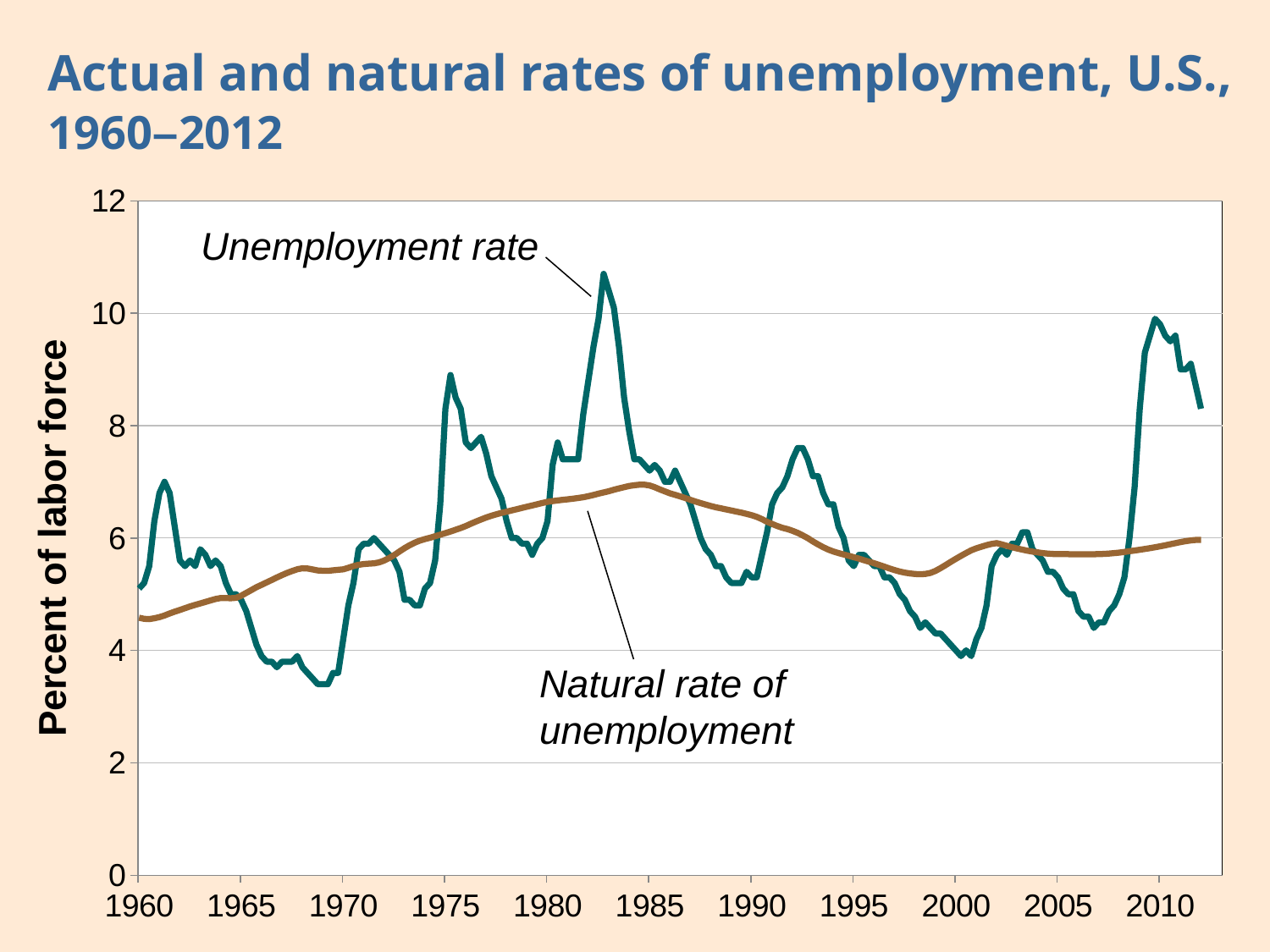
What is the label on the vertical axis? Percent of labor force How many series are plotted on the chart? 2 Is the natural rate of unemployment in 1960 greater or less than 6? less What kind of chart is shown on the slide? line chart Is the unemployment rate in 2010 greater or less than 8? greater In 1983, which series is higher: the unemployment rate or the natural rate of unemployment? Unemployment rate Is the natural rate of unemployment in 1985 greater or less than 6? greater What is the title of the chart? Actual and natural rates of unemployment, U.S., 1960–2012 In 2000, which series is higher: the unemployment rate or the natural rate of unemployment? Natural rate of unemployment Does the natural rate of unemployment rise or fall between 1960 and 1985? rise